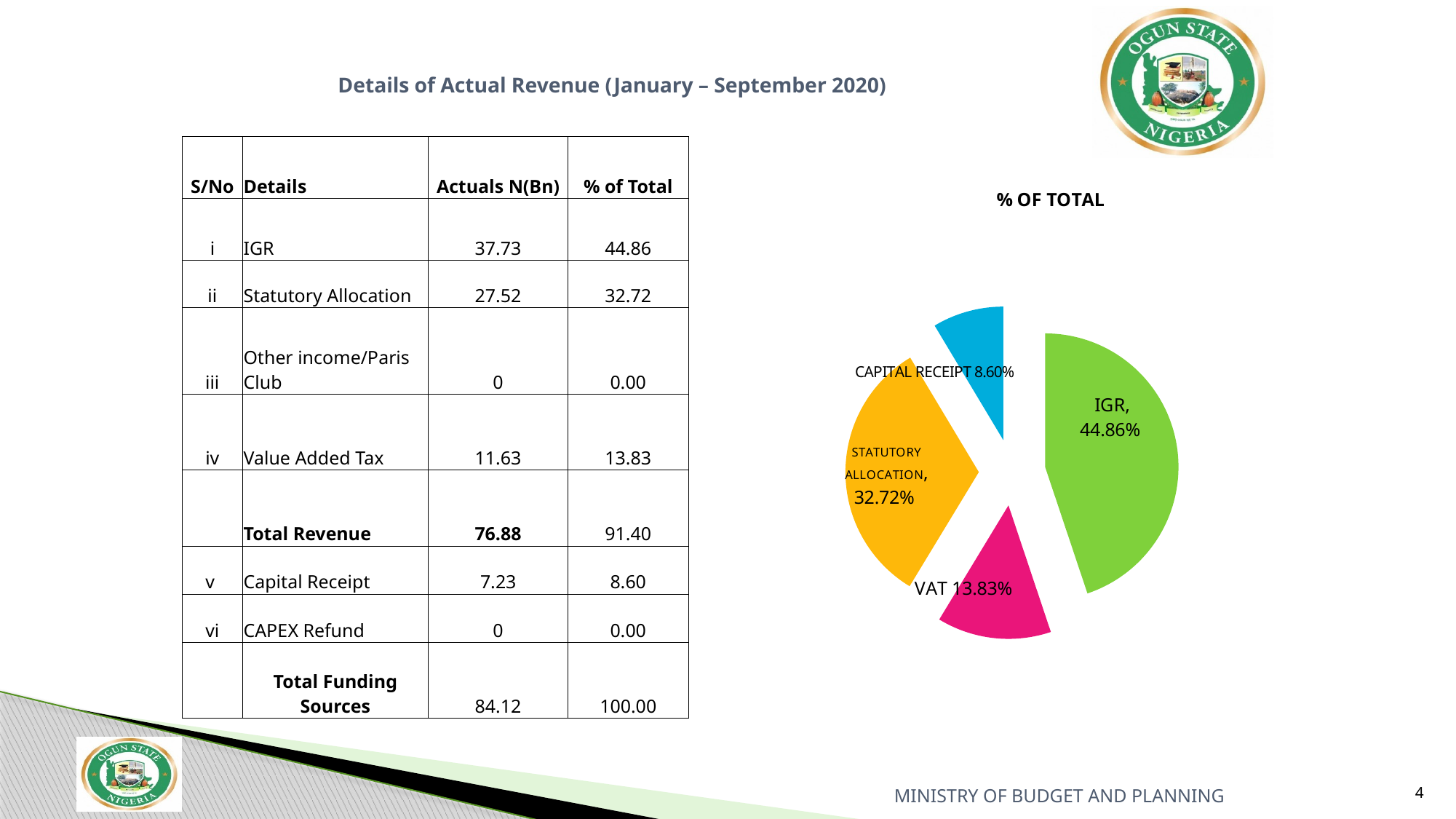
What share of the pie does Statutory Allocation represent? 32.72% Which slice of the pie chart is the smallest? Capital Receipt What type of chart is shown on the slide? pie chart What share of the pie does VAT represent? 13.83% Which slice of the pie chart is the largest? IGR Which is larger in the pie chart, Statutory Allocation or VAT? Statutory Allocation What is the difference in percentage points between the IGR slice and the Statutory Allocation slice? 12.14 What is the title of the chart? % OF TOTAL What share of the pie does Capital Receipt represent? 8.60% What colour is the IGR slice in the pie chart? green How many slices does the pie chart have? 4